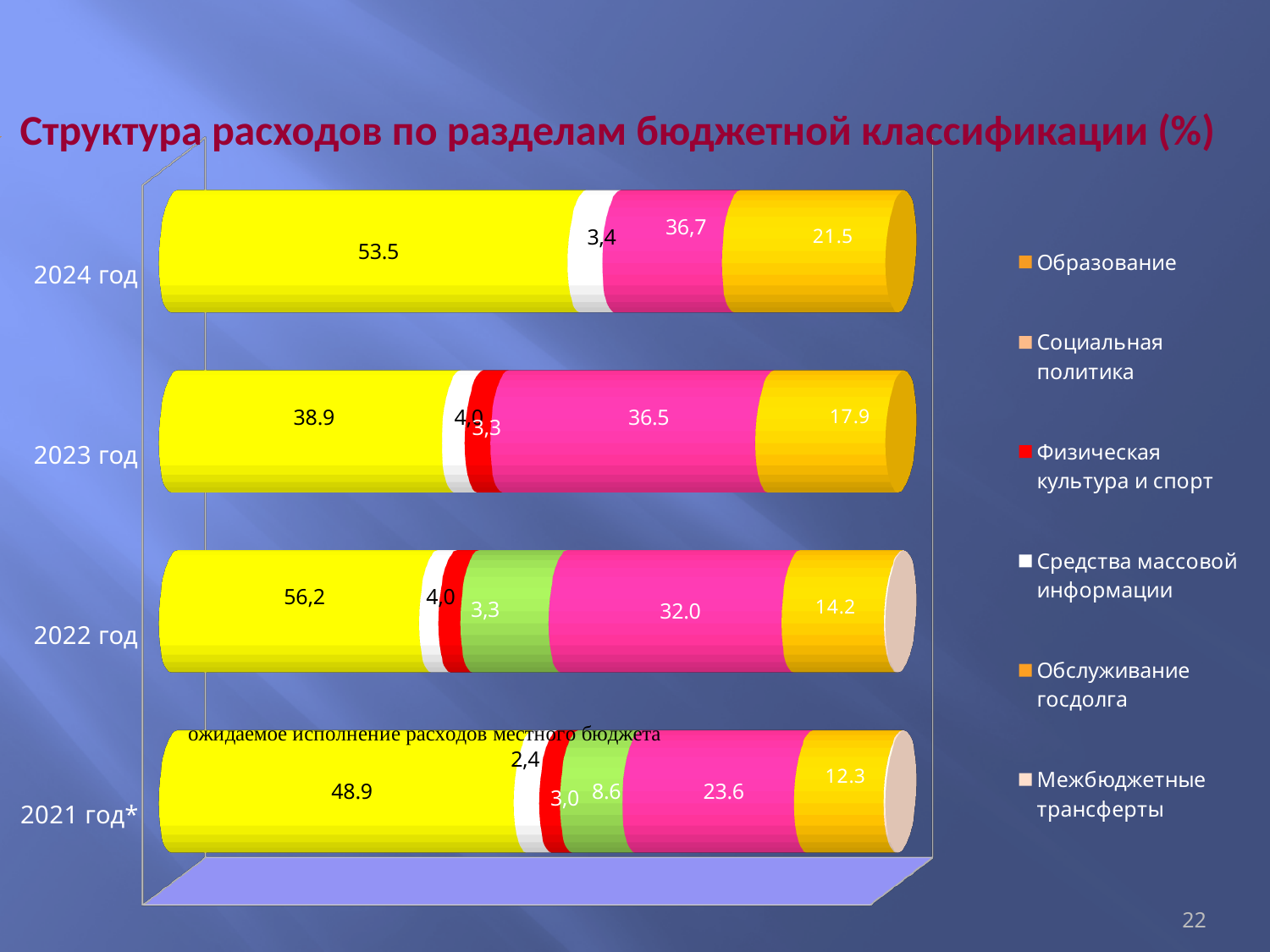
What is the value of the rightmost orange segment of the 2022 год bar? 14.2 How many years (categories) are plotted in the chart? 4 Does the rightmost orange segment rise or fall from 2021 год* to 2024 год? rises What is the value of the leftmost yellow segment of the 2024 год bar? 53.5 What is the value of the pink segment of the 2021 год* bar? 23.6 What is the title of the chart? Структура расходов по разделам бюджетной классификации (%) Which year has the smallest rightmost orange segment? 2021 год* How many series does the legend list? 6 What is the value of the leftmost yellow segment of the 2023 год bar? 38.9 What kind of chart is shown on the slide? stacked bar chart What is the difference between the rightmost orange segment of 2024 год (21.5) and that of 2021 год* (12.3)? 9.2